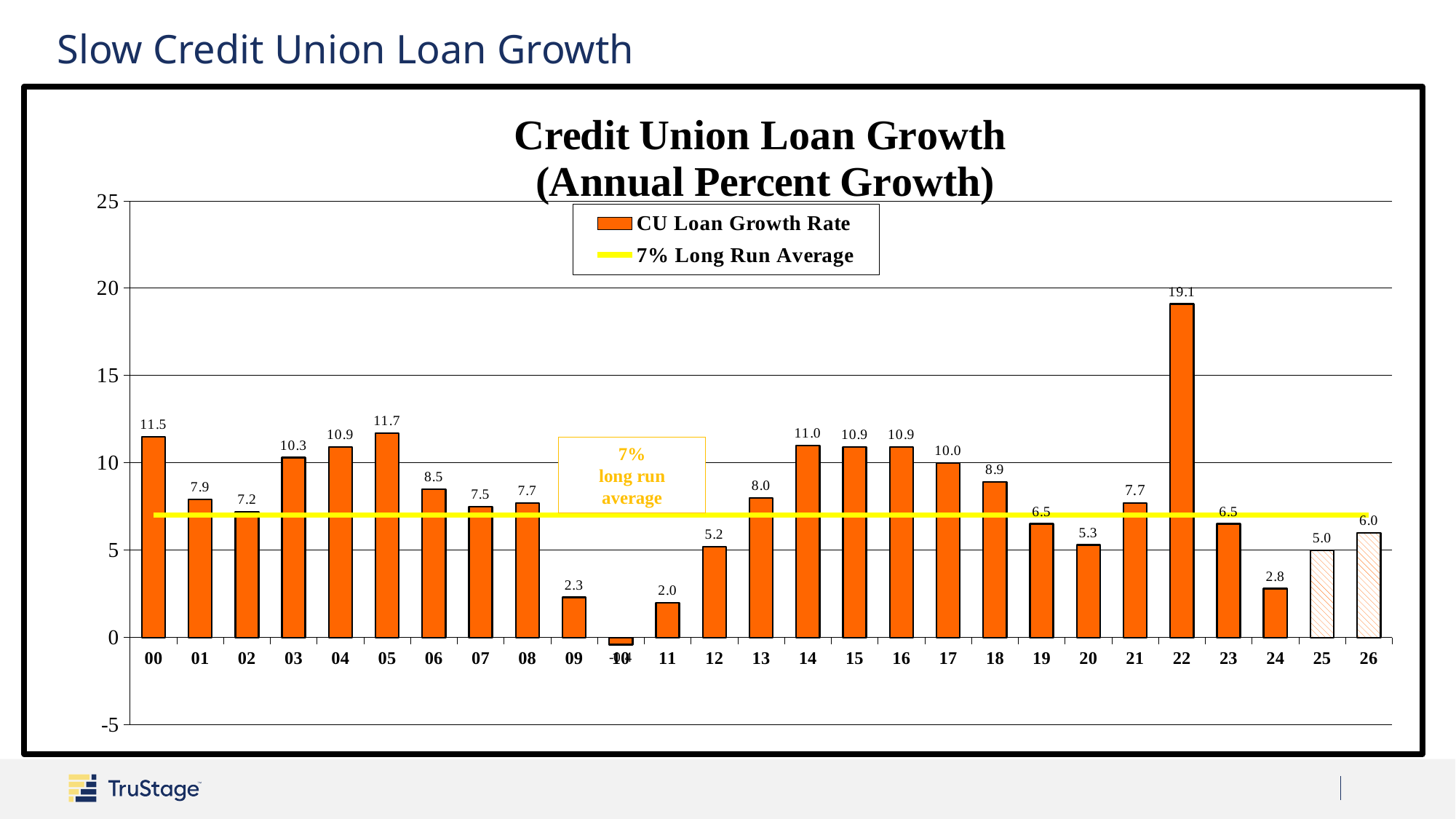
What kind of chart is shown on the slide? bar chart What is the CU Loan Growth Rate for 24? 2.8 How many years are shown on the x axis of the chart? 27 Which year has the lowest CU Loan Growth Rate? 10 Which year has a higher CU Loan Growth Rate, 14 or 18? 14 What is the difference between the CU Loan Growth Rate for 22 and for 23? 12.6 Which year has the highest CU Loan Growth Rate? 22 What value does the yellow horizontal line represent? 7% Long Run Average What is the CU Loan Growth Rate for 22? 19.1 Is the CU Loan Growth Rate for 09 greater or less than 5? less What is the CU Loan Growth Rate for 05? 11.7 How many series does the legend list? 2